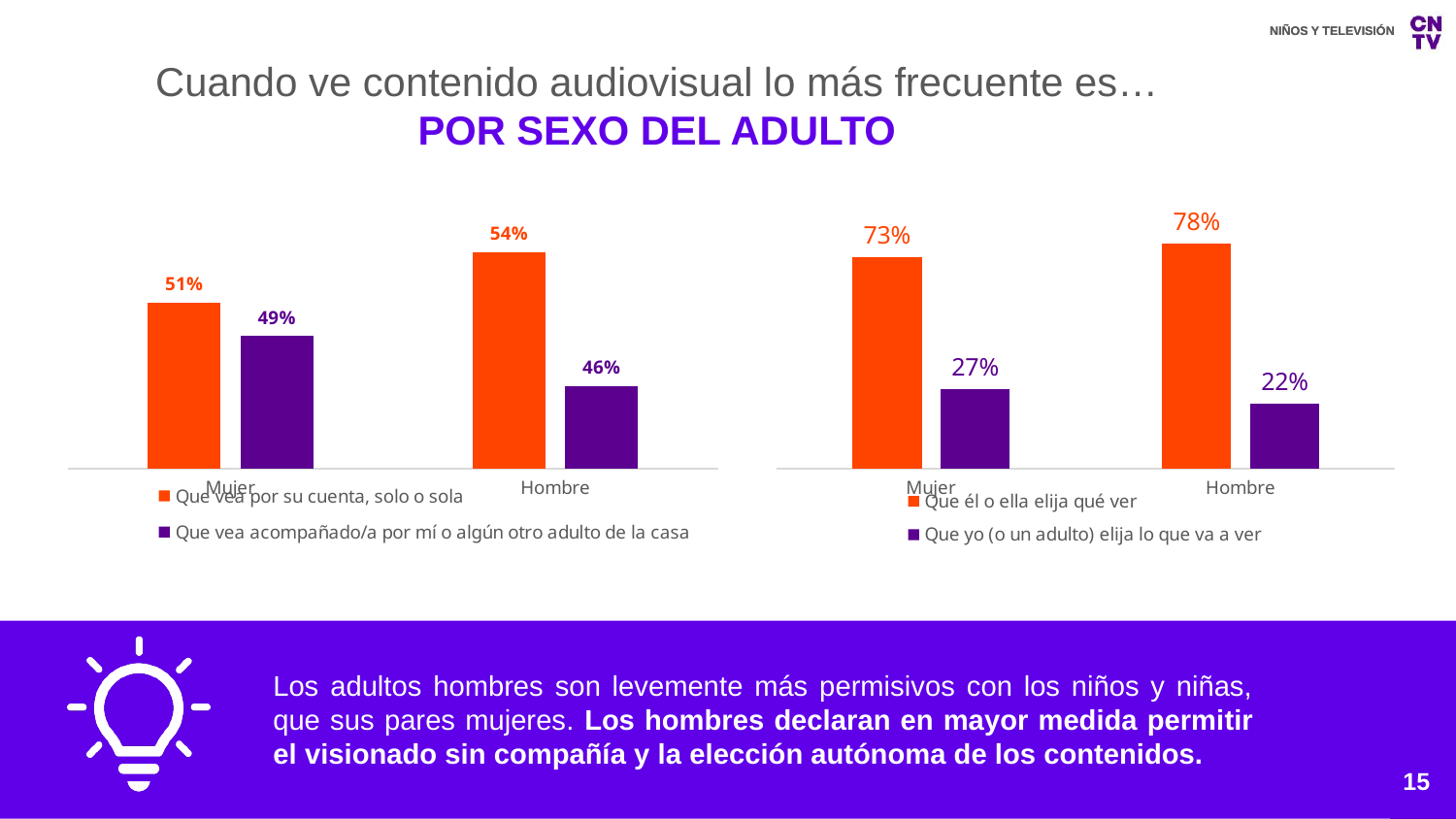
In the right chart, which is larger: 'Que yo (o un adulto) elija lo que va a ver' for Mujer or for Hombre? Mujer In the left chart, what is the value for 'Que vea acompañado/a por mí o algún otro adulto de la casa' for Mujer? 49% How many categories are shown on the x axis of the left chart? 2 In the right chart, what is the difference between the 'Que él o ella elija qué ver' values for Hombre and Mujer? 5% What type of chart is the left chart? Bar chart In the left chart, what is the value for 'Que vea por su cuenta, solo o sola' for Hombre? 54% In the left chart, what is the difference between the 'Que vea por su cuenta, solo o sola' values for Hombre and Mujer? 3% In the right chart, what is the value for 'Que él o ella elija qué ver' for Mujer? 73% In the right chart, what is the value for 'Que yo (o un adulto) elija lo que va a ver' for Hombre? 22% In the left chart, which category has the lowest value for 'Que vea acompañado/a por mí o algún otro adulto de la casa'? Hombre How many series does the legend of the right chart list? 2 In the right chart, which category has the highest value for 'Que él o ella elija qué ver'? Hombre